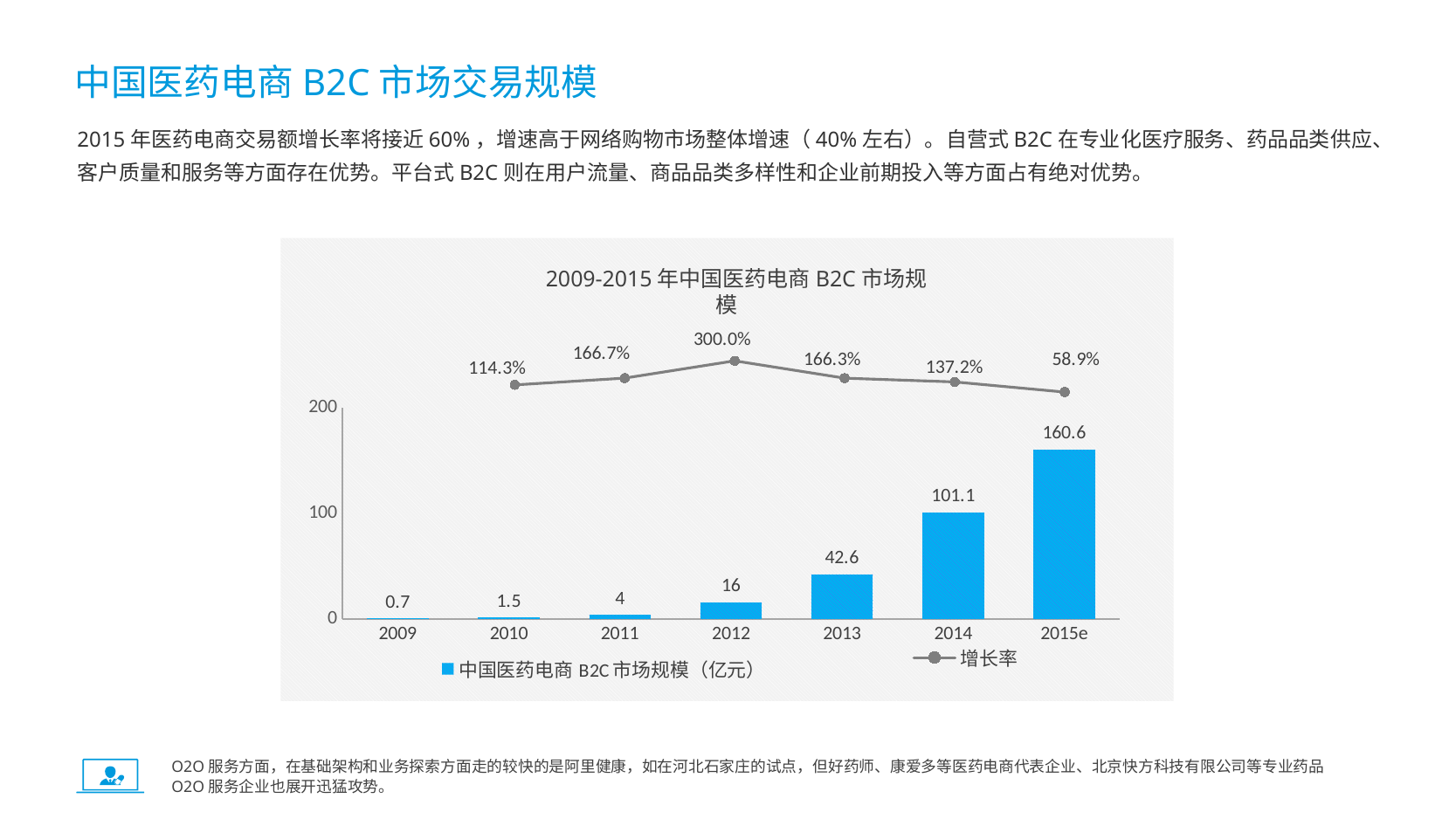
What is the market size (亿元) for 2015e? 160.6 Which is larger, the market size for 2013 or for 2012? 2013 Which year has the highest growth rate? 2012 How many years are shown on the x axis? 7 What is the difference in market size between 2015e and 2014? 59.5 Is the market size for 2015e greater or less than 100? greater What is the market size (亿元) for 2014? 101.1 What is the growth rate (增长率) shown for 2012? 300.0% How many series does the legend list? 2 Does the market size rise or fall from 2009 to 2015e? rise What kind of chart is used for the market size series? bar chart Which year has the lowest market size? 2009